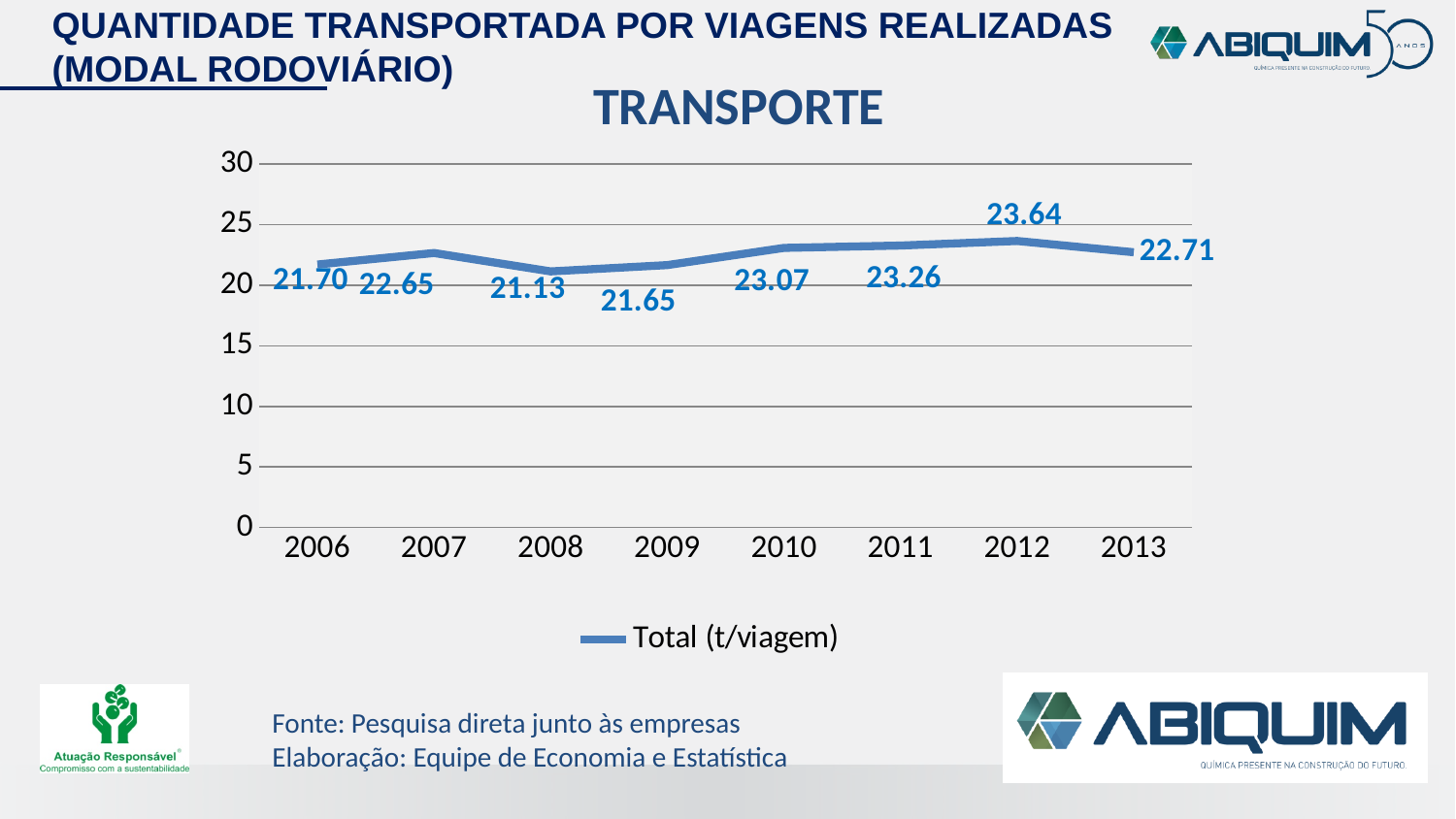
Which year has the highest value? 2012 Which is larger, the value for 2007 or the value for 2009? 2007 What is the value for 2013? 22.71 What is the legend entry for the plotted series? Total (t/viagem) What is the value for 2012? 23.64 How many years are plotted on the x axis? 8 What is the difference between the values for 2012 and 2008? 2.51 Which year has the lowest value? 2008 What kind of chart is shown? line chart What is the value for 2006? 21.70 Is the value for 2011 greater or less than 20? greater How many series does the legend list? 1